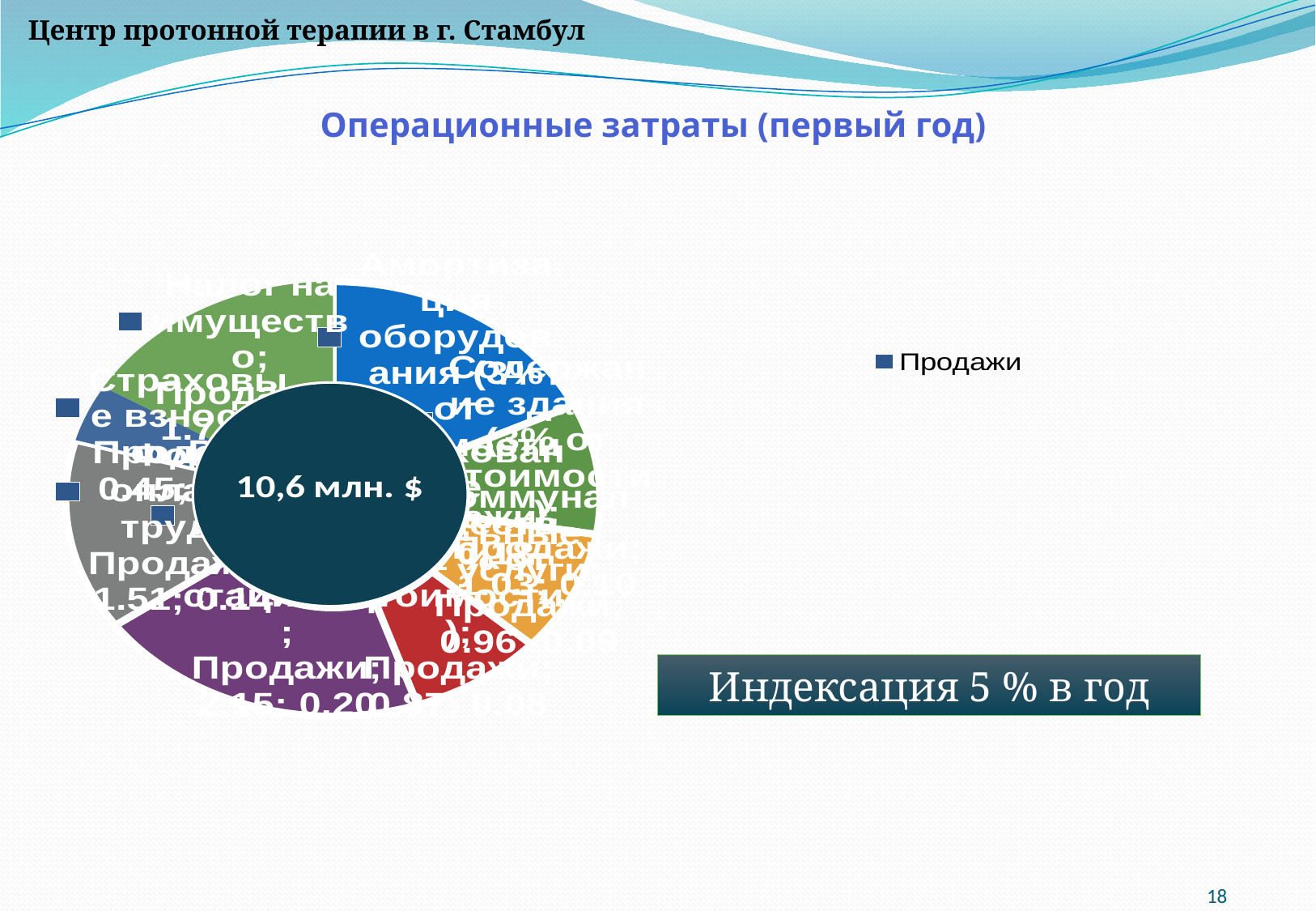
What is the title of the chart? Операционные затраты (первый год) What entry does the chart legend list? Продажи What value is printed in the centre of the doughnut chart? 10,6 млн. $ How many series does the legend list? 1 What kind of chart is shown on the slide? doughnut (pie) chart How many slices does the doughnut chart have? 8